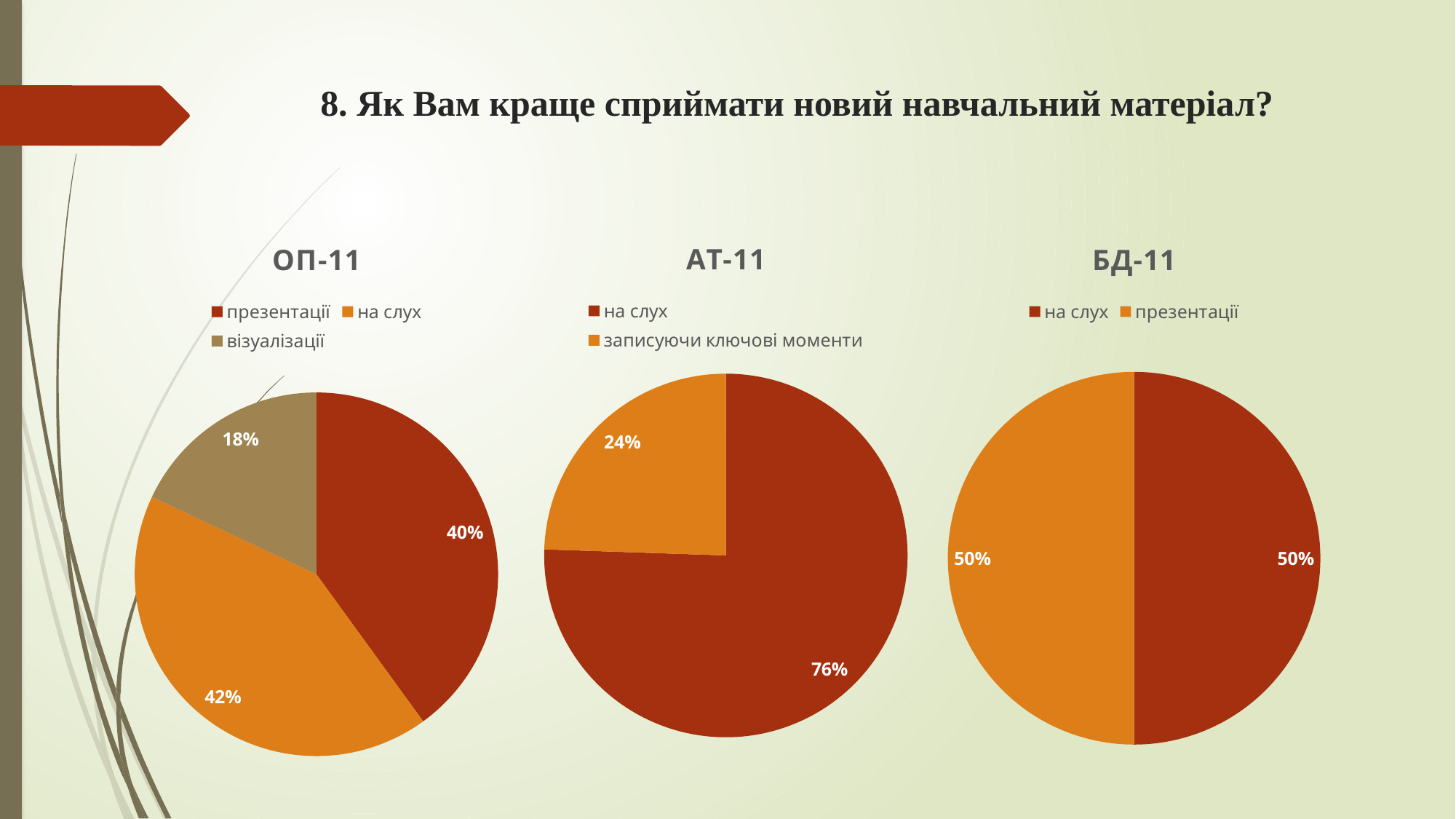
How many slices does the ОП-11 chart have? 3 In the АТ-11 chart, what share is labelled for записуючи ключові моменти? 24% In the ОП-11 chart, what is the difference between the shares for на слух and презентації? 2% In the АТ-11 chart, which is larger: на слух or записуючи ключові моменти? на слух In the ОП-11 chart, what share is labelled for візуалізації? 18% What type of chart is the АТ-11 chart? pie chart In the БД-11 chart, what share is labelled for презентації? 50% In the АТ-11 chart, what share is labelled for на слух? 76% How many entries does the legend of the БД-11 chart list? 2 In the ОП-11 chart, what share is labelled for презентації? 40% In the ОП-11 chart, which category has the smallest slice? візуалізації In the ОП-11 chart, which category has the largest slice? на слух